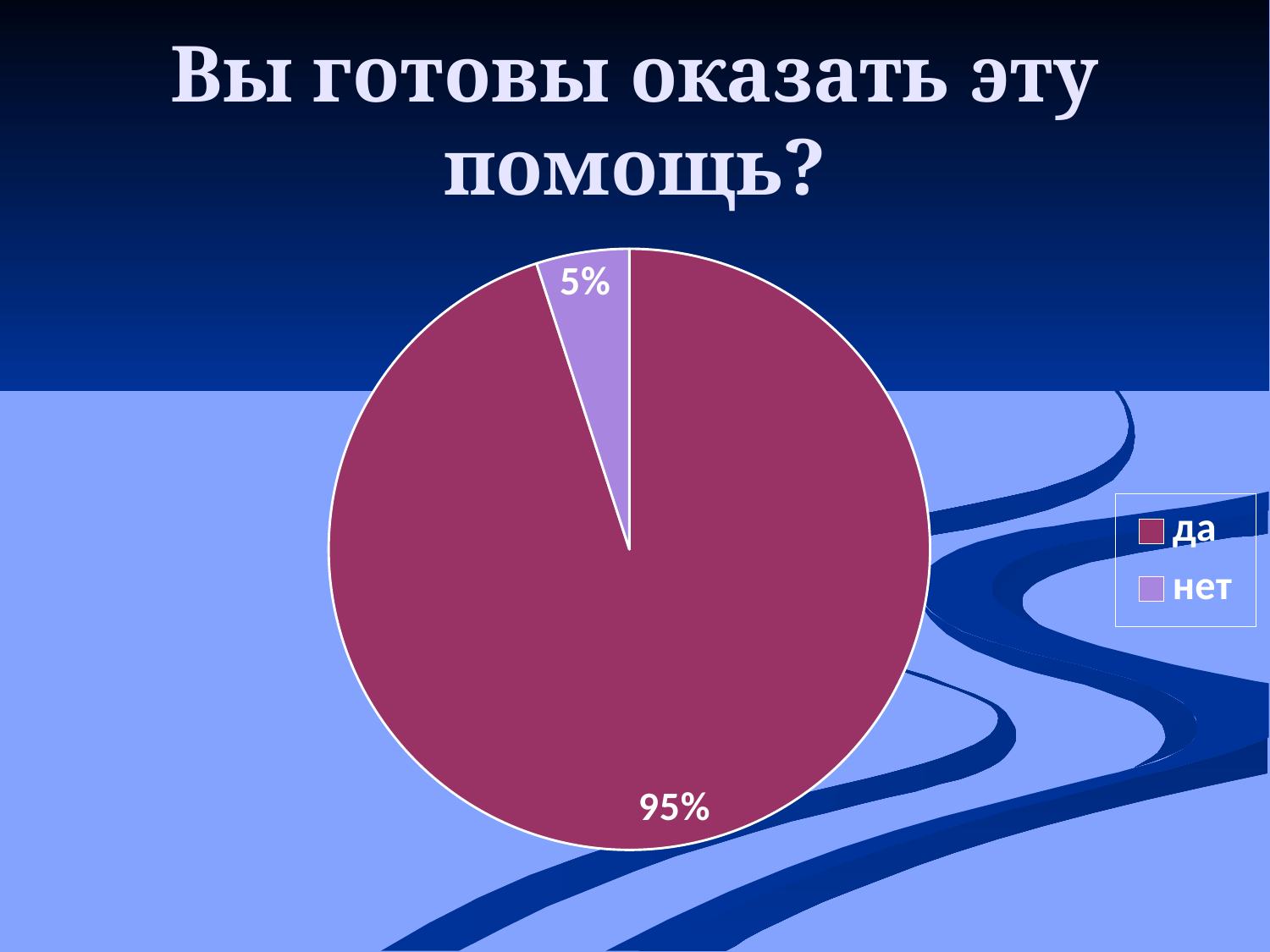
Which category has the smallest share of the pie? нет What is the title of the slide containing the chart? Вы готовы оказать эту помощь? What type of chart is shown on the slide? pie chart What percentage of the pie is labelled "нет"? 5% What colour is the "нет" slice in the pie chart? light purple What is the difference in percentage points between the "да" and "нет" slices? 90 Which slice is larger, "да" or "нет"? да What percentage of the pie is labelled "да"? 95% How many slices does the pie chart have? 2 How many entries does the legend list? 2 Which category has the largest share of the pie? да